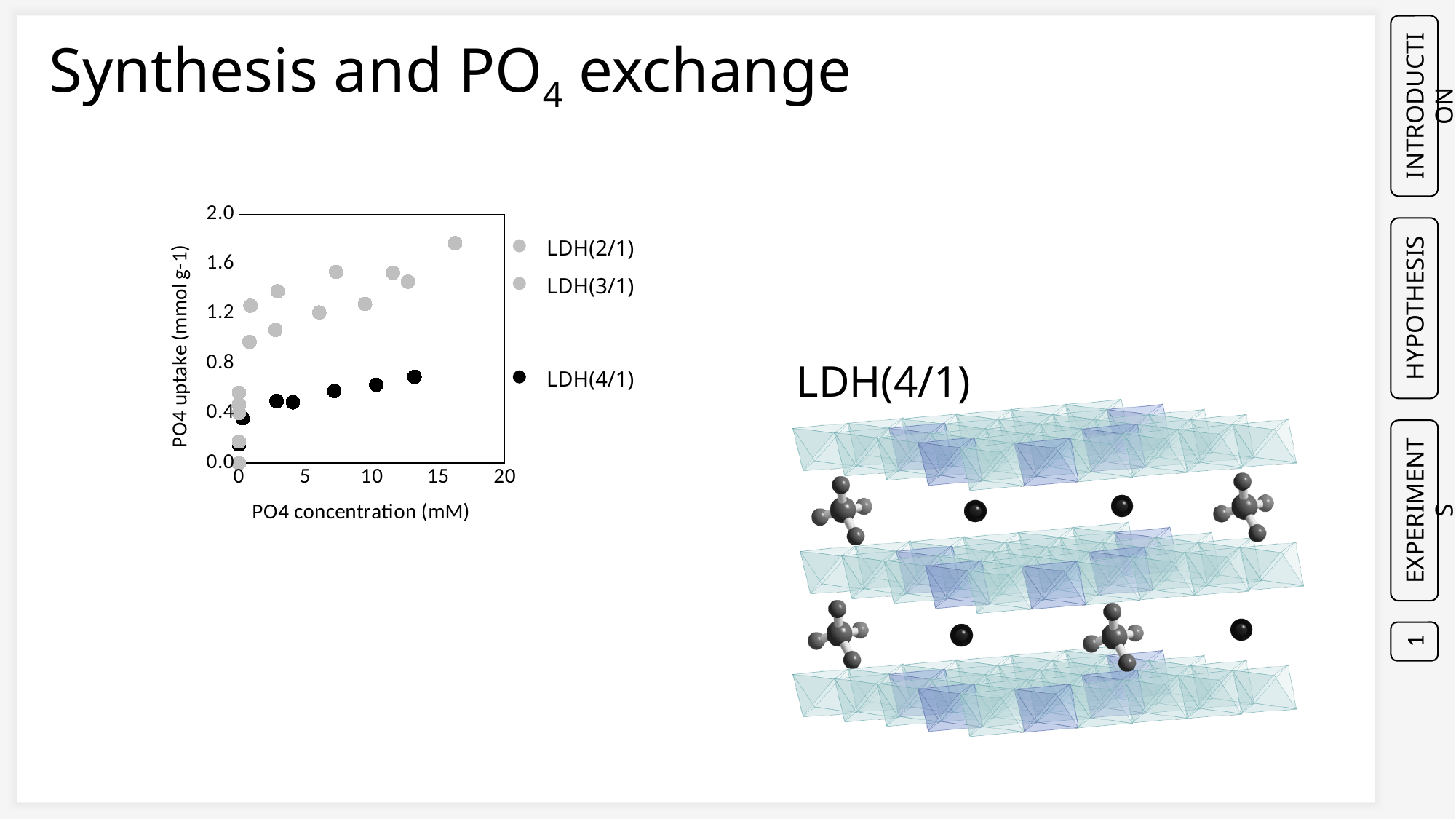
At a PO4 concentration of about 13 mM, is the uptake for LDH(4/1) higher or lower than the grey series? lower Is the highest PO4 uptake value for LDH(4/1) greater or less than 0.8? less Is the PO4 uptake for LDH(4/1) at about 13 mM greater or less than 0.4? greater Does the PO4 uptake for LDH(4/1) rise or fall as PO4 concentration increases? rise What is the label of the y axis of the chart? PO4 uptake (mmol g-1) Is the highest PO4 uptake value plotted on the chart greater or less than 1.6? greater What kind of chart is shown on the slide? scatter chart Which series has the lowest PO4 uptake values across the concentration range? LDH(4/1) What is the label of the x axis of the chart? PO4 concentration (mM) How many series does the chart legend list? 3